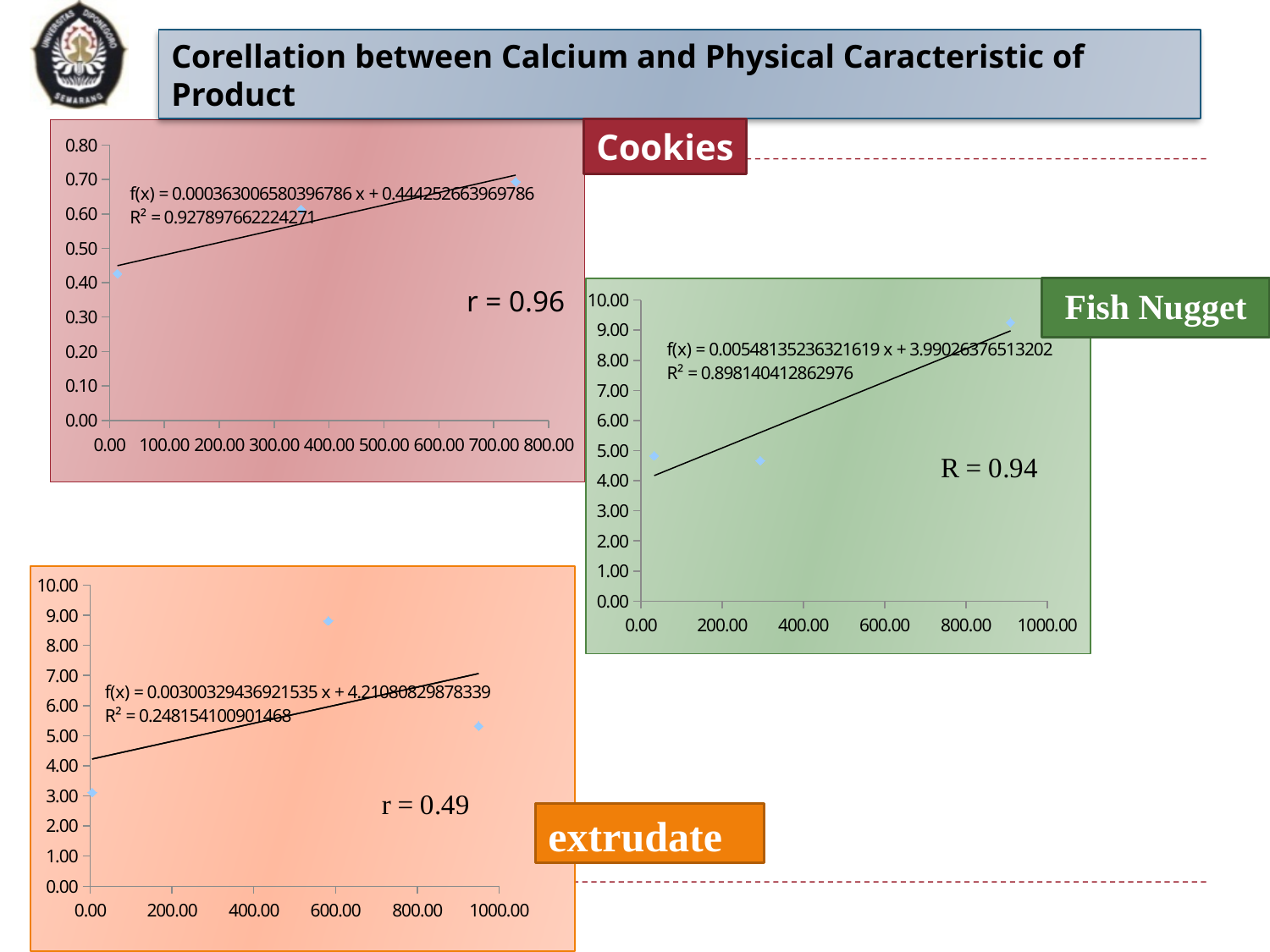
On the extrudate chart, what is the R² value shown? 0.248154100901468 On the Cookies chart, what is the R² value shown? 0.927897662224271 Which of the three charts reports the lowest correlation coefficient? extrudate On the extrudate chart, what is the r value shown? 0.49 On the Cookies chart, does the fitted trendline rise or fall as x increases? rises On the Cookies chart, what is the correlation coefficient r shown? 0.96 On the Fish Nugget chart, what is the R value shown? 0.94 What kind of chart is the Cookies chart? scatter chart On the Fish Nugget chart, what is the R² value shown? 0.898140412862976 How many data points are plotted on the extrudate chart? 3 On the Cookies chart, is the value of the rightmost data point (near x = 700) greater or less than 0.60? greater On the extrudate chart, is the value of the data point near x = 600 greater or less than 8.00? greater